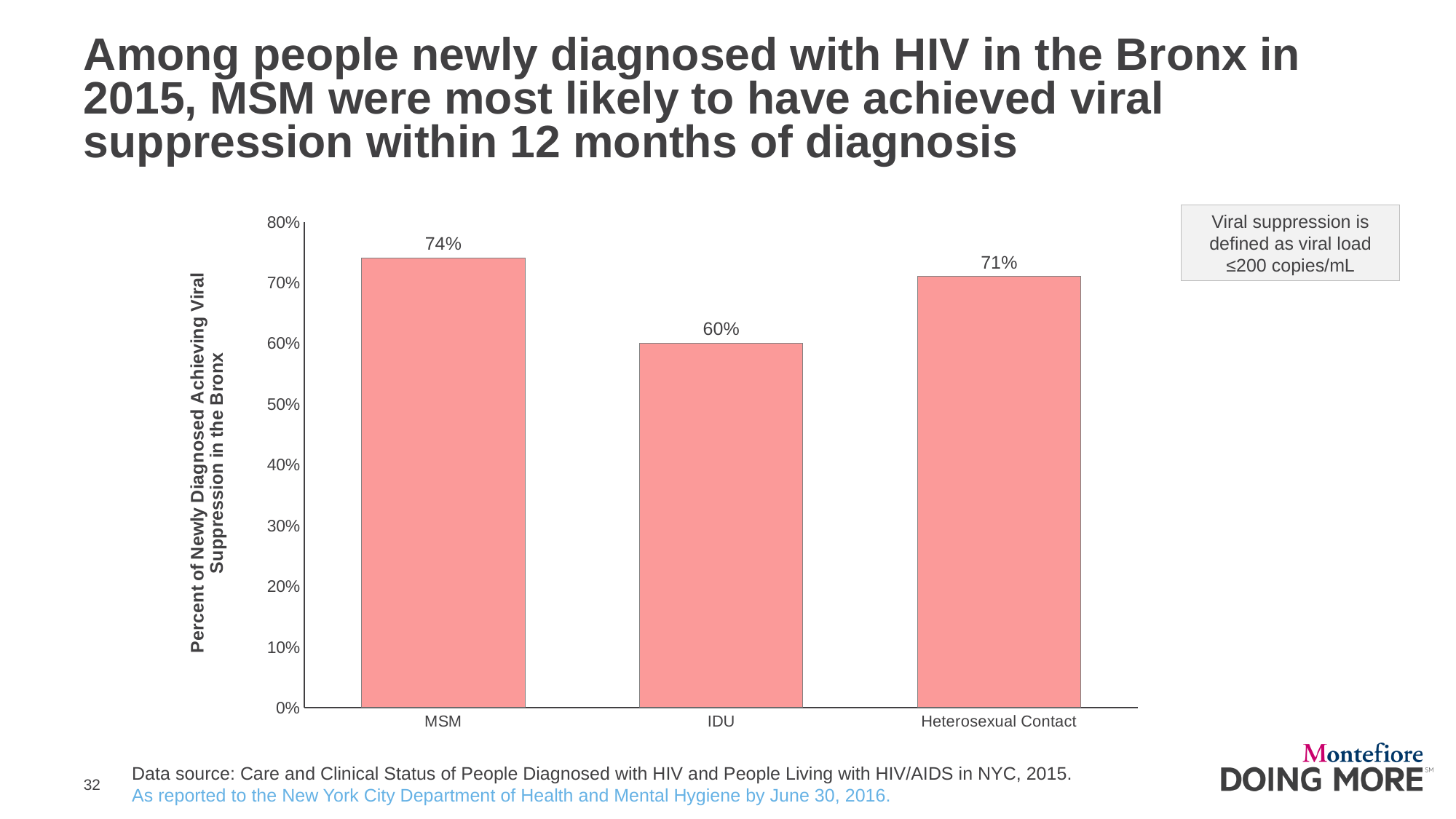
What is the difference in percentage points between MSM and Heterosexual Contact? 3 What is the label of the vertical axis? Percent of Newly Diagnosed Achieving Viral Suppression in the Bronx Is the value for IDU greater or less than 70%? less Which category has the highest percent achieving viral suppression? MSM What is the value shown for Heterosexual Contact? 71% What is the difference in percentage points between MSM and IDU? 14 What percent of newly diagnosed MSM in the Bronx achieved viral suppression? 74% How many categories are shown on the x axis? 3 Which category has the lowest percent achieving viral suppression? IDU What is the value shown for IDU? 60% Which is larger, the value for IDU or the value for Heterosexual Contact? Heterosexual Contact What kind of chart is shown on the slide? Bar chart